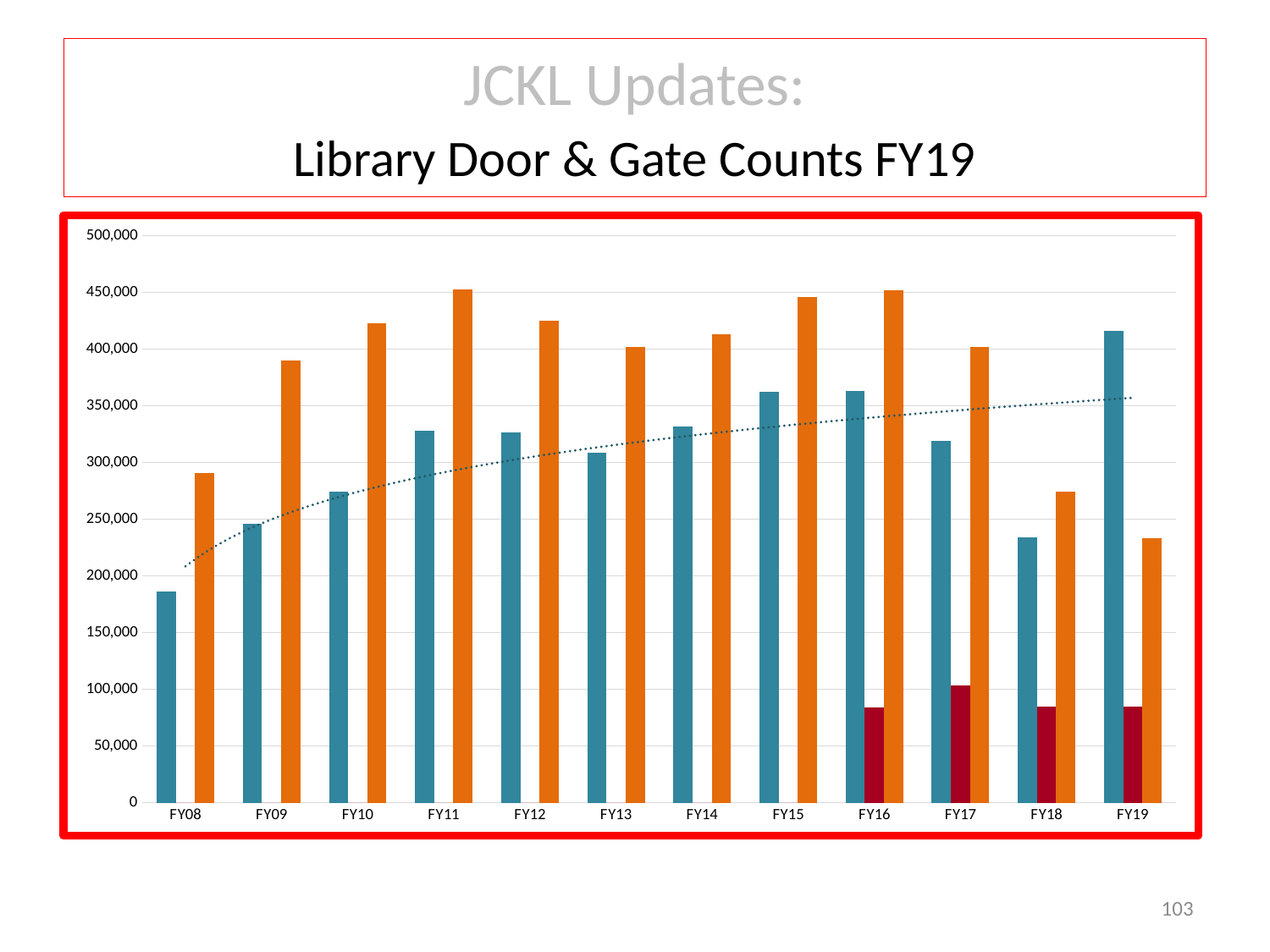
Which fiscal year has the shortest orange bar? FY19 How many fiscal years are shown on the x axis of the chart? 12 What kind of chart is shown on the slide? bar chart Which fiscal year has the tallest dark red bar? FY17 Is the dark red bar for FY16 greater or less than 100,000? less How many fiscal years have a dark red bar? 4 Is the blue bar for FY19 greater or less than 400,000? greater Do the blue bars rise or fall from FY08 to FY11? rise Is the blue bar for FY08 greater or less than 200,000? less Which fiscal year has the shortest blue bar? FY08 For FY19, which is larger, the blue bar or the orange bar? the blue bar Which fiscal year has the tallest blue bar? FY19